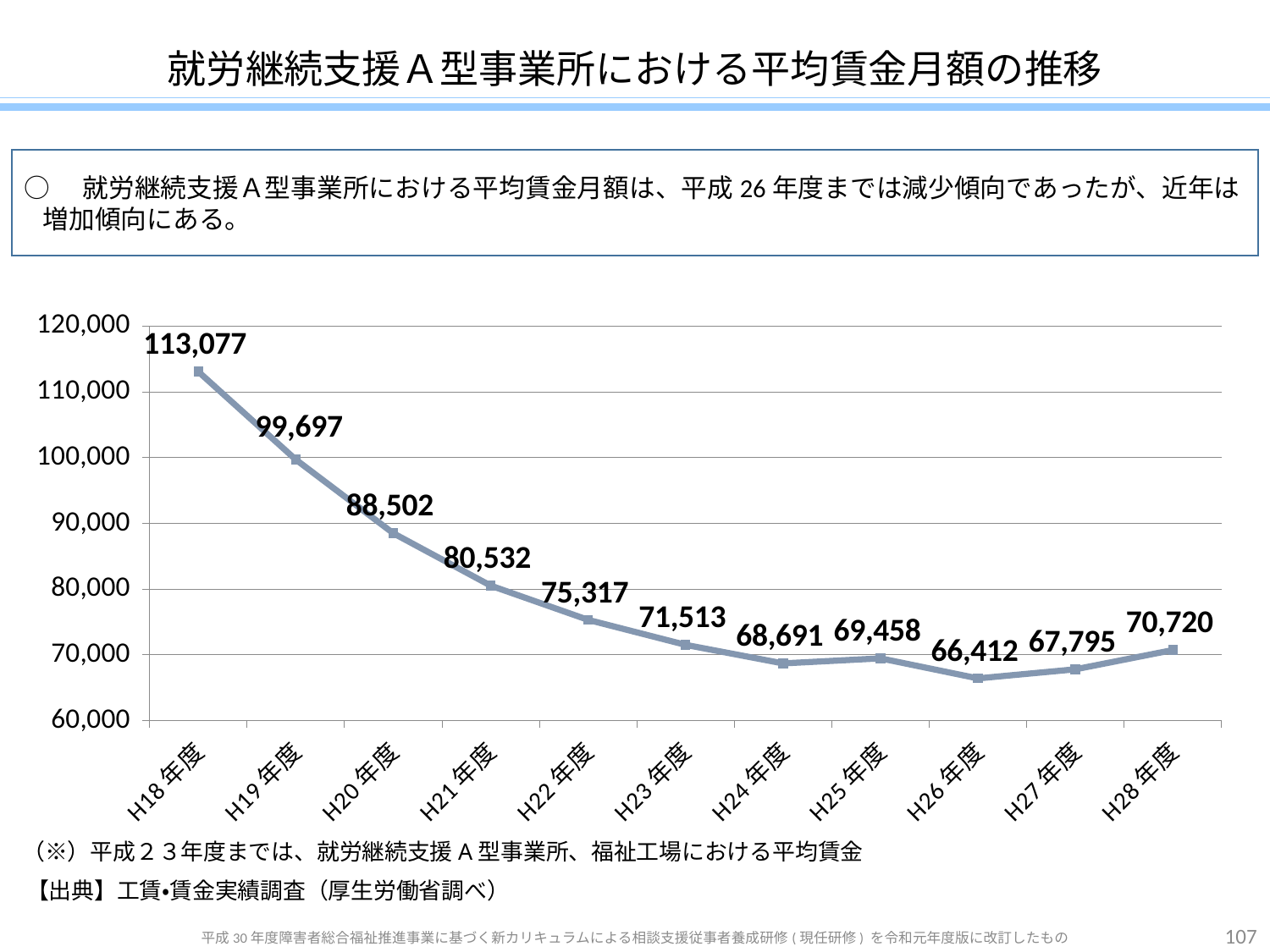
What is the difference between the values for H18年度 and H19年度? 13,380 Do the values rise or fall from H18年度 to H24年度? fall Which is larger, the value for H24年度 or the value for H25年度? H25年度 Which fiscal year has the lowest value on the chart? H26年度 Which fiscal year has the highest value on the chart? H18年度 What is the difference between the values for H28年度 and H27年度? 2,925 What is the value plotted for H26年度? 66,412 Is the value for H21年度 greater or less than 80,000? greater How many fiscal years are plotted on the chart? 11 What is the average monthly wage for H18年度? 113,077 What kind of chart is shown on the slide? line chart What is the value plotted for H28年度? 70,720